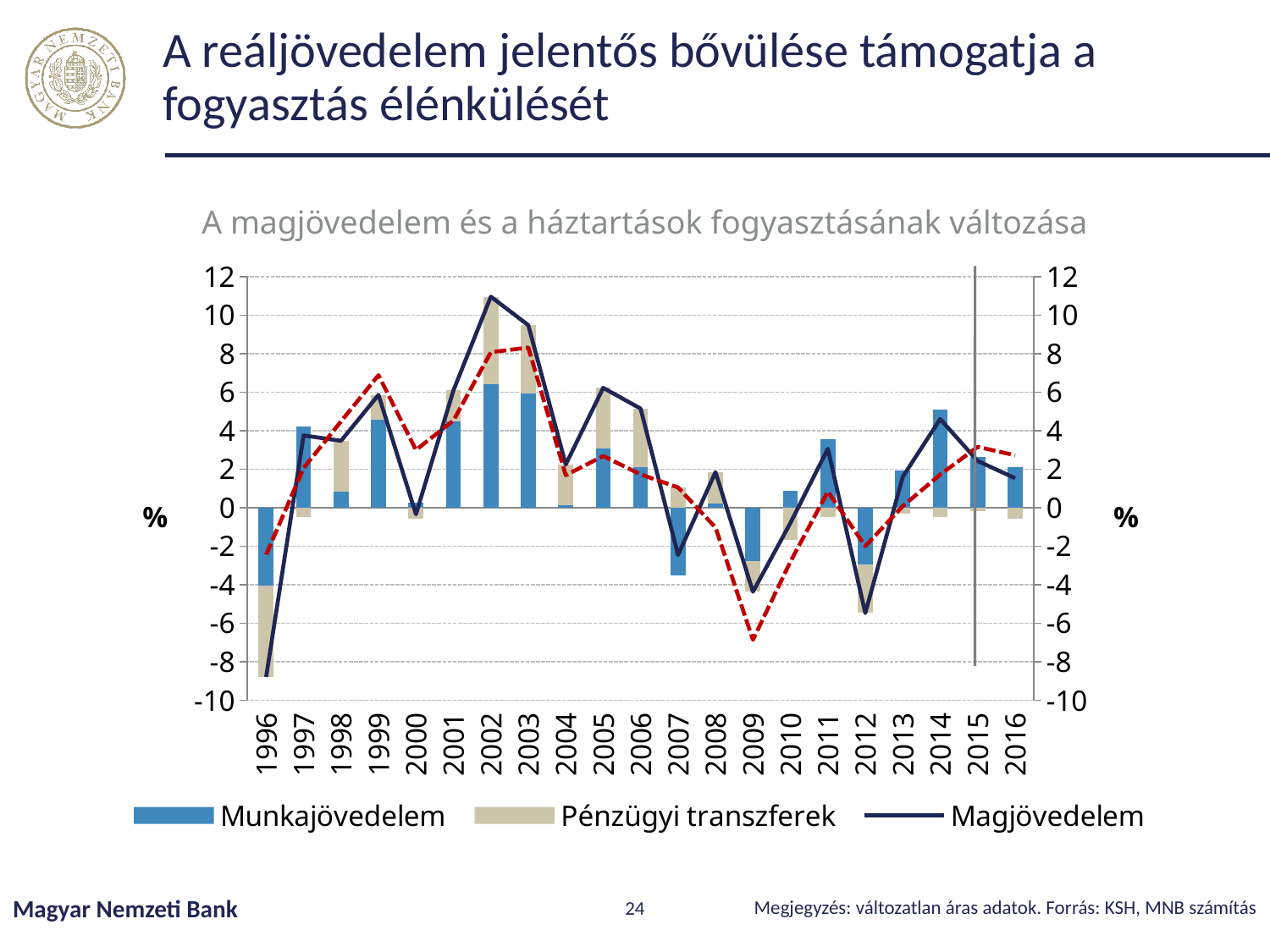
Is the Magjövedelem value for 2002 greater or less than 10? greater Which year has the larger Magjövedelem value, 2002 or 2003? 2002 In which year does the Magjövedelem line reach its lowest value? 1996 Is the Magjövedelem value for 2012 greater or less than -4? less How many series does the chart legend list? 3 What is the title of the chart? A magjövedelem és a háztartások fogyasztásának változása What unit is shown on the vertical axes of the chart? % Is the Munkajövedelem bar for 2007 greater or less than -2? less Does the Magjövedelem line rise or fall from 2012 to 2014? rise In which year does the Magjövedelem line reach its highest value? 2002 What kind of chart is shown on the slide? A combined bar and line chart How many years are shown on the x axis of the chart? 21